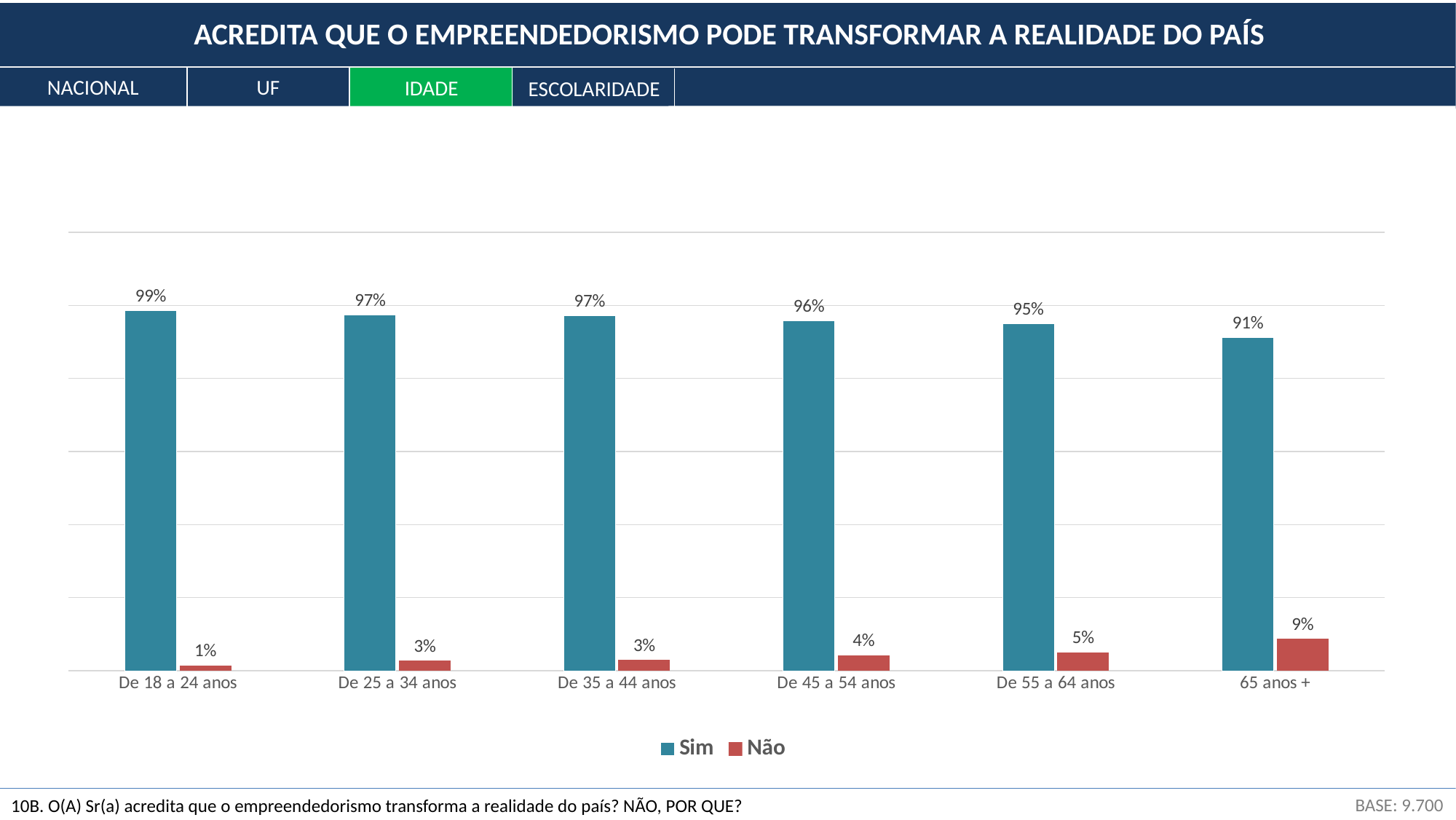
What is the "Não" value for "65 anos +"? 9% Which age group has the highest "Não" value? 65 anos + What is the "Sim" value for "De 18 a 24 anos"? 99% What is the difference between the "Sim" values for "De 18 a 24 anos" and "65 anos +"? 8% What kind of chart is shown on the slide? Bar chart What is the "Sim" value for "De 45 a 54 anos"? 96% What is the "Não" value for "De 55 a 64 anos"? 5% How many age groups are shown on the x axis? 6 How many series does the legend list? 2 Which age group has the highest "Sim" value? De 18 a 24 anos Which age group has the lowest "Sim" value? 65 anos + Which is larger: the "Não" value for "De 45 a 54 anos" or for "De 25 a 34 anos"? De 45 a 54 anos